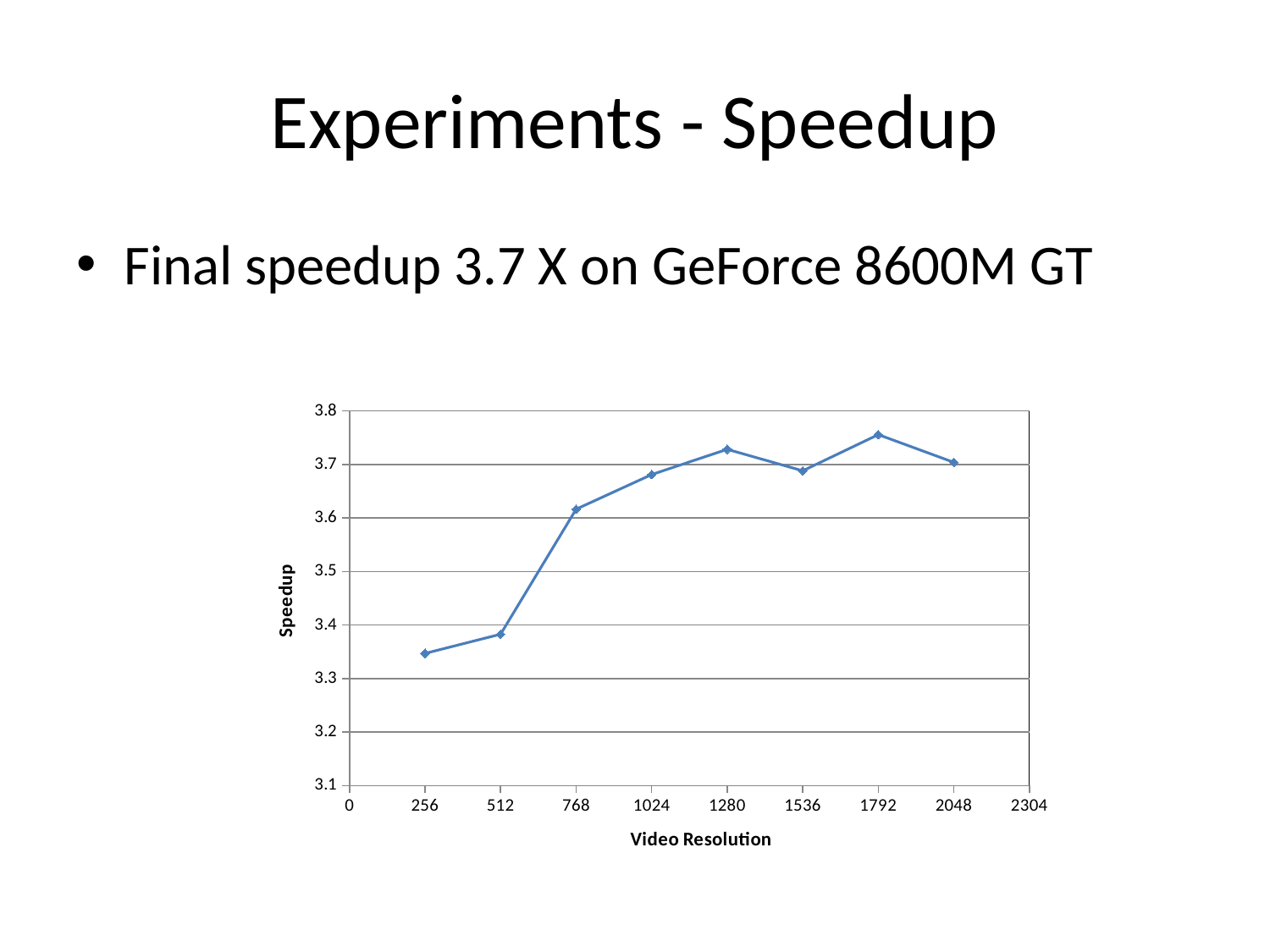
Which has the larger speedup, video resolution 1280 or 1536? 1280 Is the speedup at video resolution 1280 greater or less than 3.7? greater Is the speedup at video resolution 512 greater or less than 3.5? less What kind of chart is shown on the slide? line chart Which has the larger speedup, video resolution 512 or 768? 768 At which video resolution is the speedup lowest? 256 Is the speedup at video resolution 768 greater or less than 3.6? greater How many data points are plotted on the line? 8 At which video resolution is the speedup highest? 1792 What is the title of the x axis? Video Resolution Does the speedup generally rise or fall as video resolution increases? rise